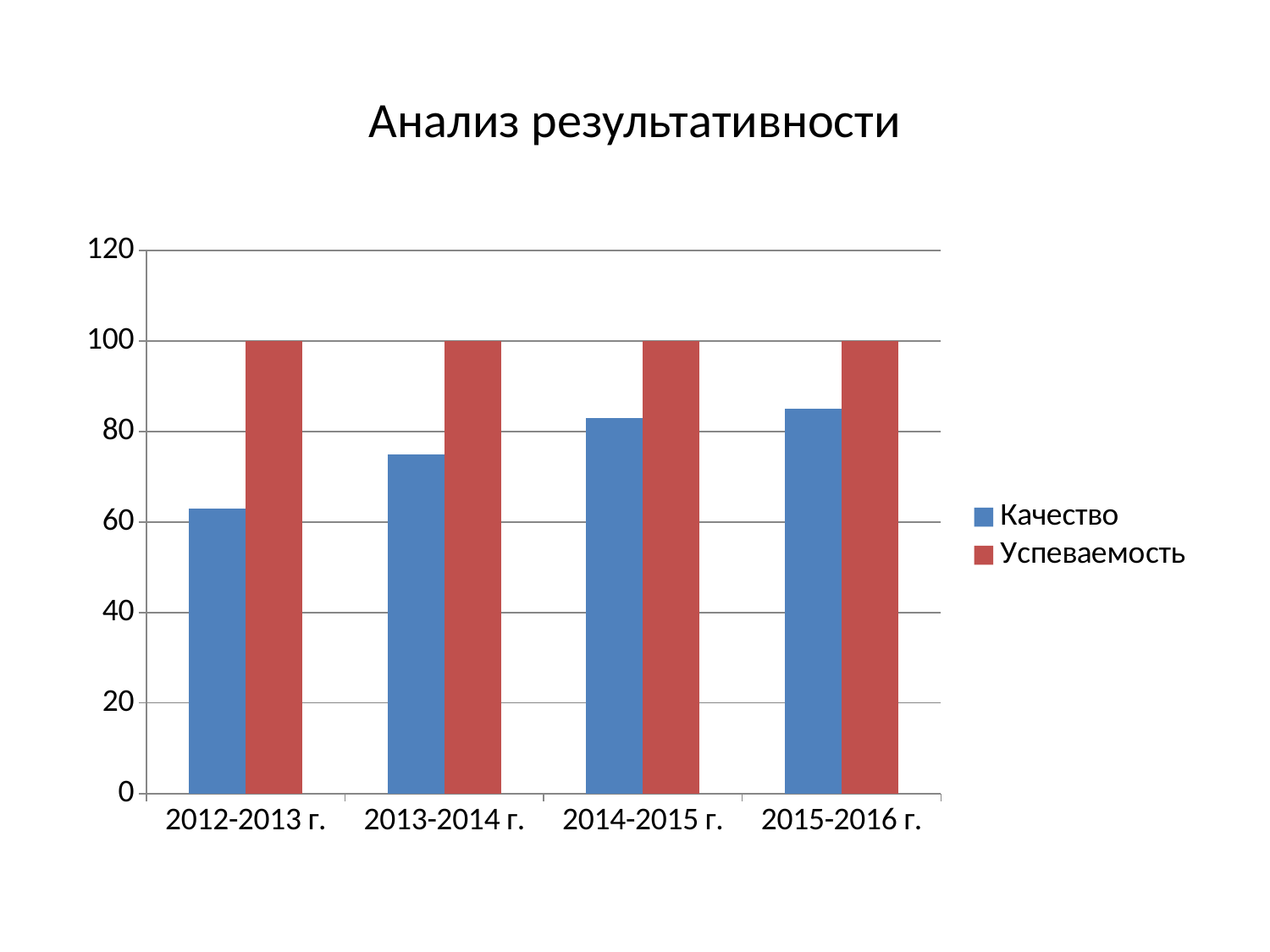
Is the value of Качество for 2015-2016 г. greater or less than 80? greater Which category has the lowest Качество value? 2012-2013 г. Do the Качество values rise or fall from 2012-2013 г. to 2015-2016 г.? rise How many series does the legend list? 2 Is the value of Качество for 2013-2014 г. greater or less than 80? less What is the title of the chart? Анализ результативности How many categories are shown on the x axis? 4 Is the value of Качество for 2012-2013 г. greater or less than 80? less What kind of chart is shown on the slide? bar chart What is the value of Успеваемость for 2012-2013 г.? 100 What is the value of Успеваемость for 2015-2016 г.? 100 Which is larger, Качество for 2012-2013 г. or Качество for 2015-2016 г.? 2015-2016 г.